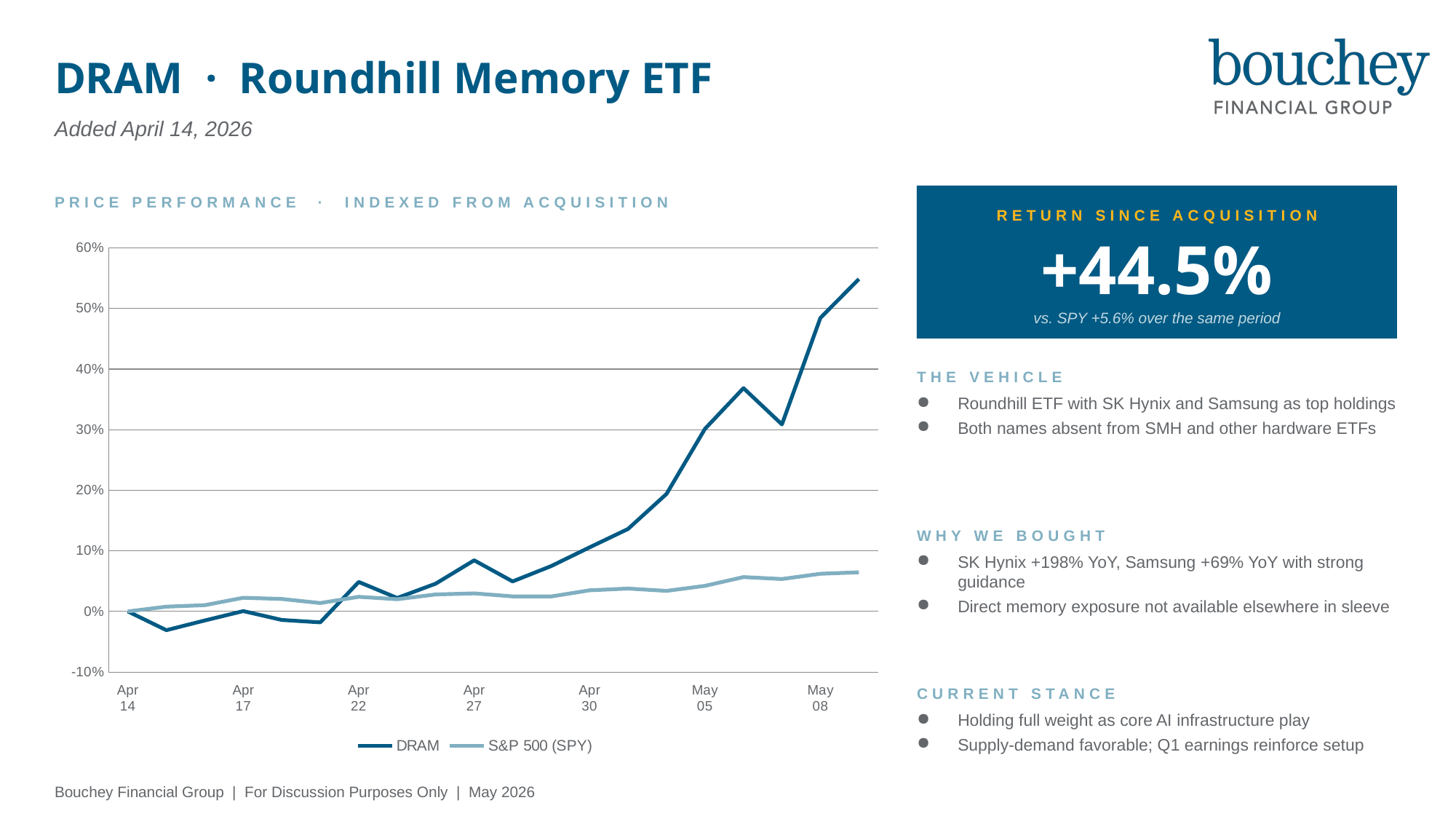
What are the two series named in the chart legend? DRAM and S&P 500 (SPY) At Apr 22, which series has the higher value, DRAM or S&P 500 (SPY)? DRAM Which series reaches the highest value on the chart? DRAM What is the title of the chart? PRICE PERFORMANCE · INDEXED FROM ACQUISITION How many series does the chart legend list? 2 At the last point on the chart, is the S&P 500 (SPY) value greater or less than 10%? less What is the first date label shown on the x axis? Apr 14 At the last point on the chart, is the DRAM value greater or less than 50%? greater At the end of the chart, which series has the higher value, DRAM or S&P 500 (SPY)? DRAM What kind of chart is shown on the slide? Line chart At Apr 27, is the DRAM value greater or less than 10%? less Does the DRAM line rise or fall overall from Apr 14 to the end of the chart? Rise